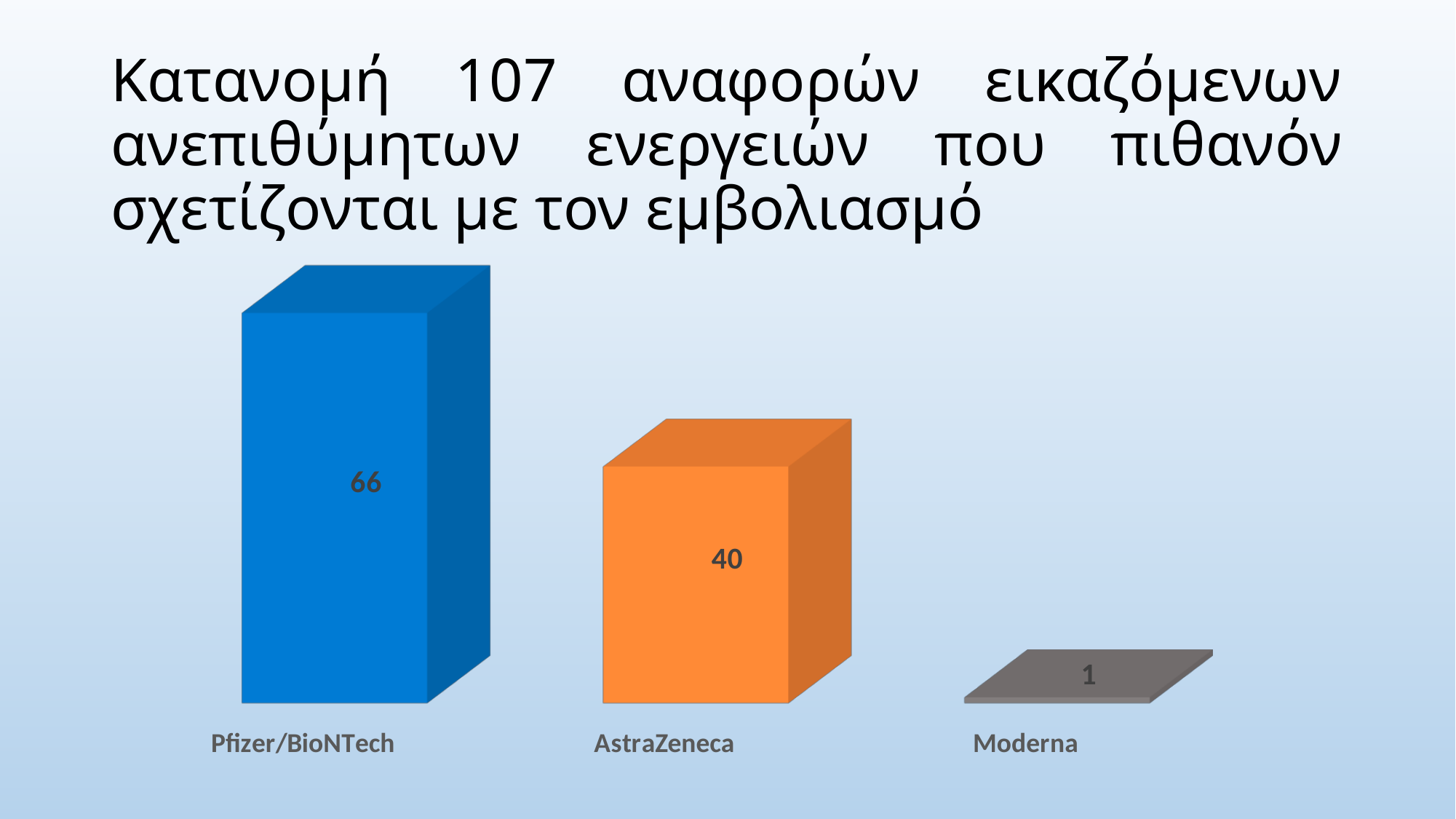
What colour is the bar for AstraZeneca? Orange How many categories are shown in the chart? 3 Which category has the highest value? Pfizer/BioNTech What is the value for Pfizer/BioNTech? 66 What is the value for AstraZeneca? 40 What is the difference between the values for AstraZeneca and Moderna? 39 What is the difference between the values for Pfizer/BioNTech and AstraZeneca? 26 What is the value for Moderna? 1 What kind of chart is shown on the slide? Bar chart Do the values rise or fall from left to right across the categories? Fall Which category has the lowest value? Moderna Which is larger, the value for AstraZeneca or the value for Moderna? AstraZeneca